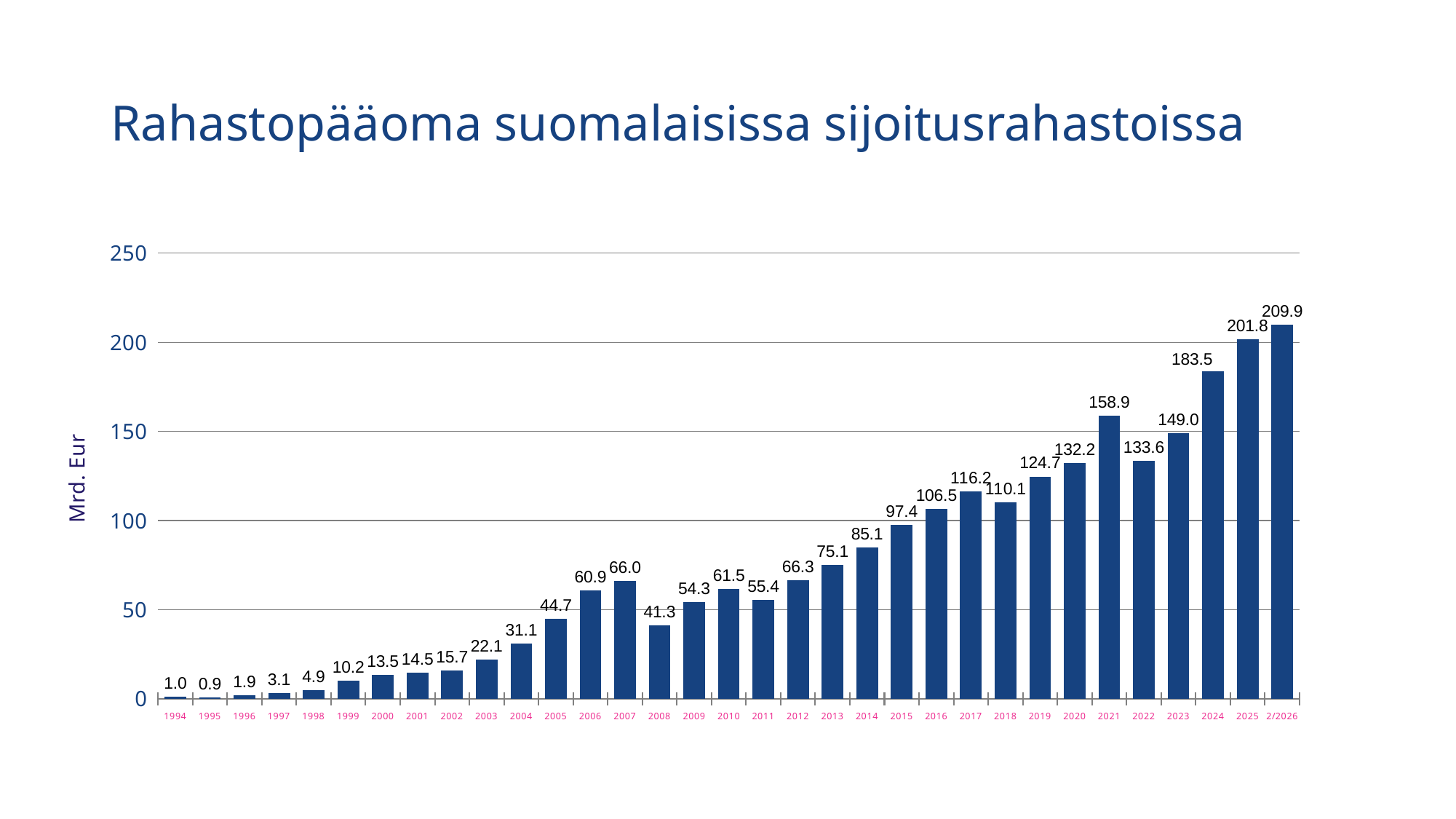
What is the value for 2021? 158.9 How many bars are plotted in the chart? 33 What is the difference between the values for 2021 and 2022? 25.3 What is the value for 2/2026? 209.9 What is the label on the vertical axis? Mrd. Eur What kind of chart is shown on the slide? bar chart Which category has the lowest value? 1995 Which category has the highest value? 2/2026 Which is larger, the value for 2007 or the value for 2008? 2007 What is the difference between the values for 2025 and 2024? 18.3 What is the value for 2008? 41.3 Is the value for 2024 greater or less than 150? greater